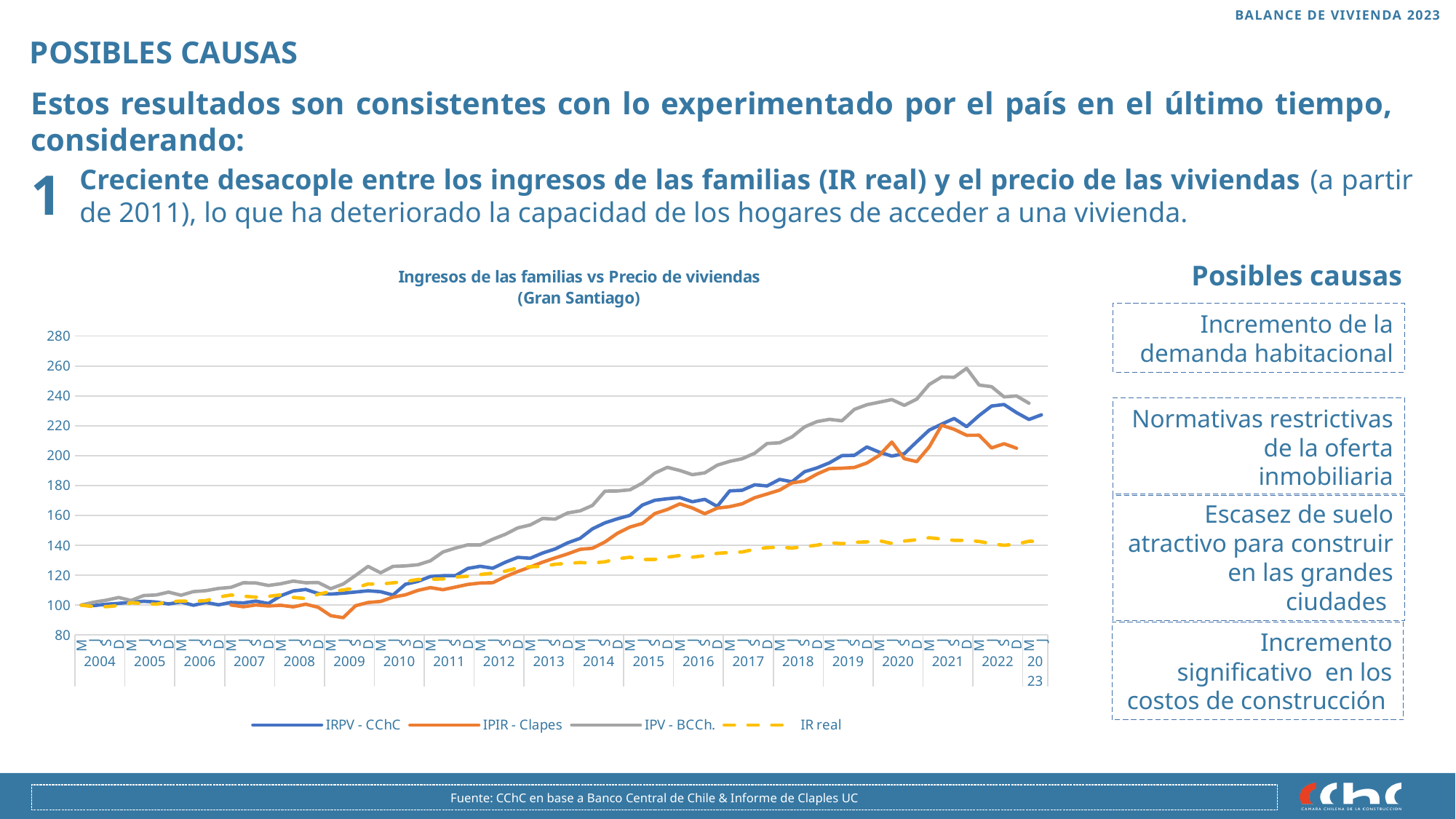
What kind of chart is shown on the slide? Line chart Does the IPV - BCCh. series generally rise or fall from 2004 to 2021? Rise How many series does the chart legend list? 4 At the end of the chart in 2023, which is larger: IPV - BCCh. or IR real? IPV - BCCh. What is the title of the chart? Ingresos de las familias vs Precio de viviendas (Gran Santiago) Is the peak value of IPV - BCCh. in 2021 greater or less than 240? greater Is the lowest value of IPIR - Clapes in 2009 greater or less than 100? less How many years are labelled on the x axis of the chart? 20 Which series in the legend is drawn as a dashed line? IR real Which series has the lowest value at the end of the chart in 2023? IR real Is the value of IR real at the end of 2023 greater or less than 160? less Which series has the highest value at the end of the chart in 2023? IPV - BCCh.